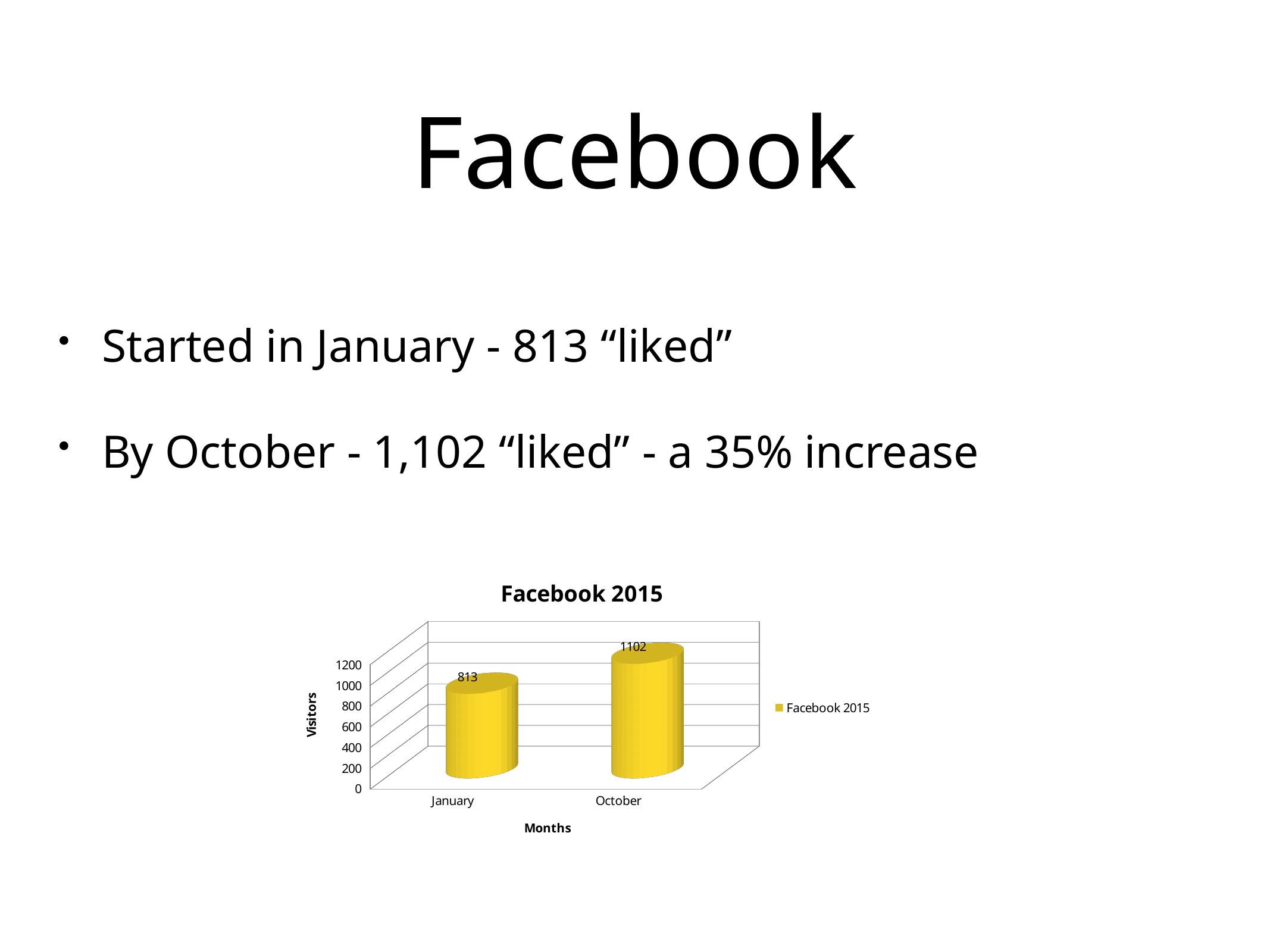
Which month has the highest value in the Facebook 2015 chart? October How many months are shown on the x axis of the Facebook 2015 chart? 2 What kind of chart is the Facebook 2015 chart? bar chart Is the value for October in the Facebook 2015 chart greater or less than 1000? greater How many series does the legend of the Facebook 2015 chart list? 1 Which is larger in the Facebook 2015 chart, the value for January or the value for October? October What is the value for January in the Facebook 2015 chart? 813 What is the difference between the October and January values in the Facebook 2015 chart? 289 What is the value for October in the Facebook 2015 chart? 1102 Which month has the lowest value in the Facebook 2015 chart? January Is the value for January in the Facebook 2015 chart greater or less than 1000? less What is the label of the vertical axis in the Facebook 2015 chart? Visitors